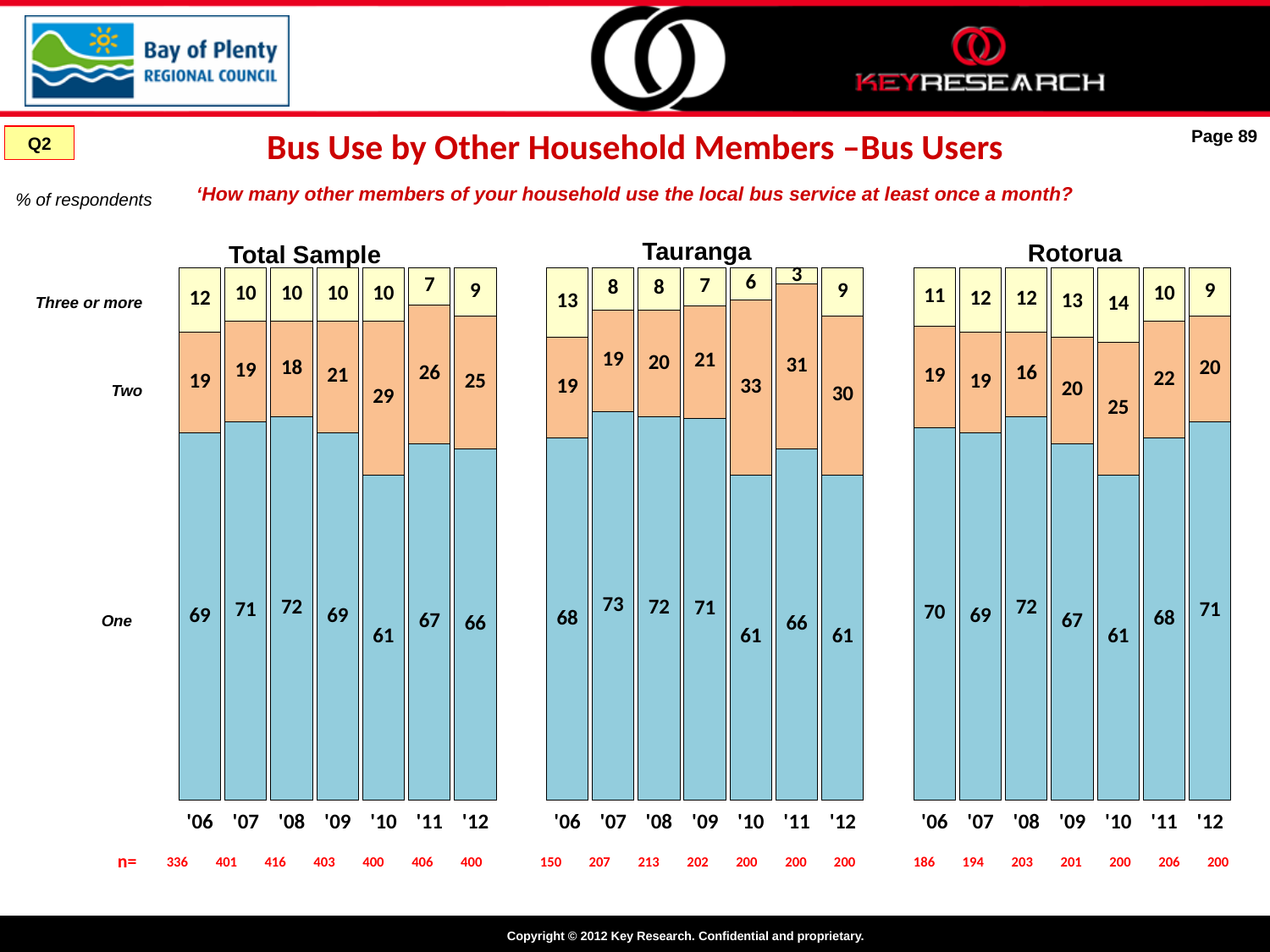
In the Total Sample chart, which year has the lowest value for 'Three or more'? '11 In the Rotorua chart, how much higher is the 'Two' value in '10 than in '08? 9 How many series (segments) make up each bar in the Tauranga chart? 3 What is the sample size (n=) shown for the Total Sample in '06? 336 In the Total Sample chart, what percentage of respondents said 'One' other household member uses the bus in '10? 61 In the Rotorua chart, what is the value for 'Three or more' in '09? 13 In the Tauranga chart, what is the value for 'Two' in '10? 33 What kind of chart is the Total Sample chart? Stacked bar chart In the Total Sample chart, is the 'Two' value larger in '10 or in '11? '10 In the Tauranga chart, what is the total of the stacked bar for '11? 100 In the Tauranga chart, which year has the highest value for 'One'? '07 How many years are shown on the x axis of the Rotorua chart? 7